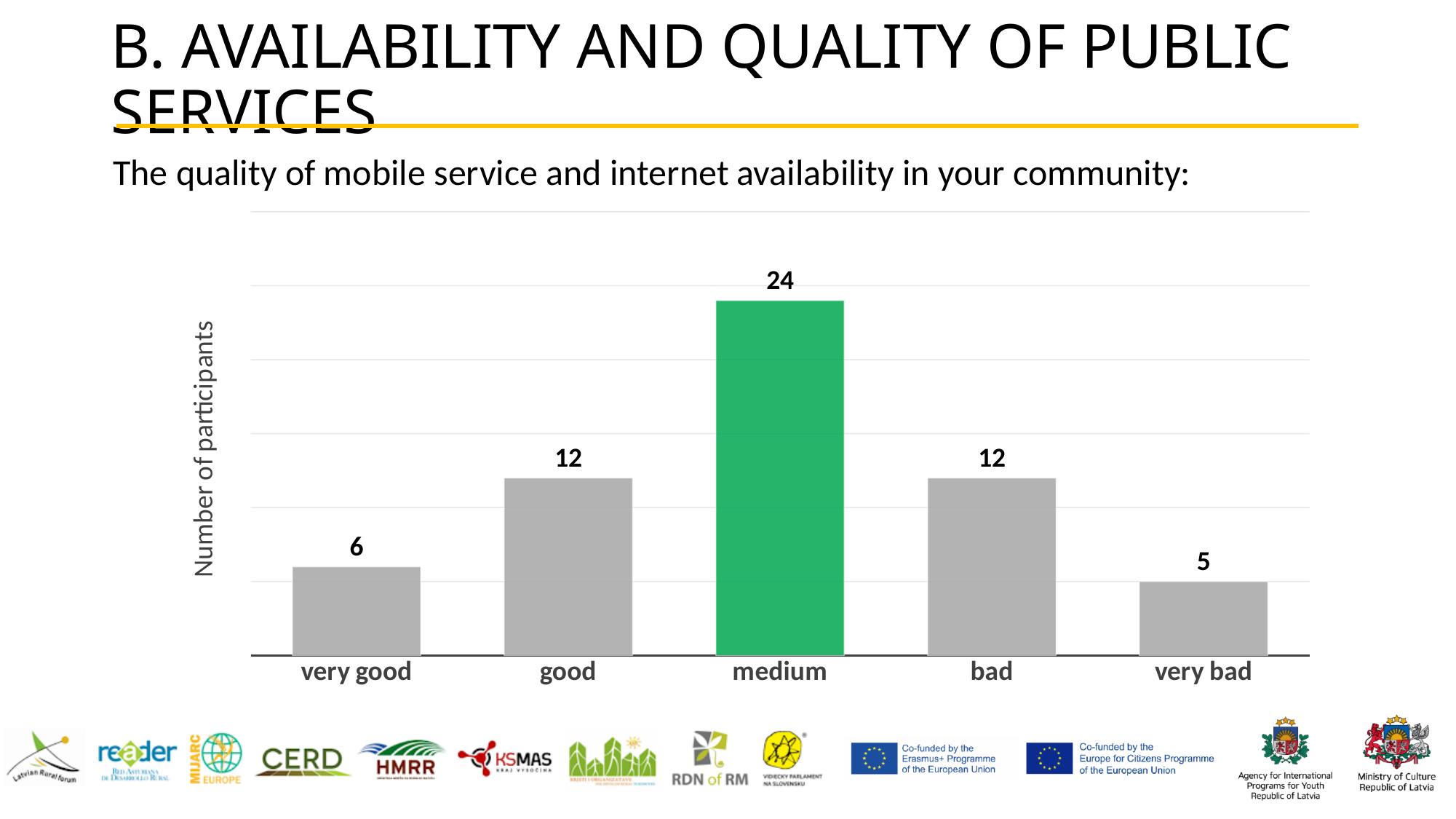
Which category has the lowest number of participants? very bad How many participants rated the quality of mobile service and internet availability as very bad? 5 What is the difference in number of participants between medium and good? 12 How many participants rated the quality of mobile service and internet availability as medium? 24 What is the label of the vertical axis of the chart? Number of participants Which has more participants, very good or bad? bad What is the difference in number of participants between very good and very bad? 1 Which category has the highest number of participants? medium What kind of chart is shown on the slide? bar chart How many participants rated the quality of mobile service and internet availability as very good? 6 How many categories are shown on the x axis of the chart? 5 Which bar in the chart is coloured green? medium